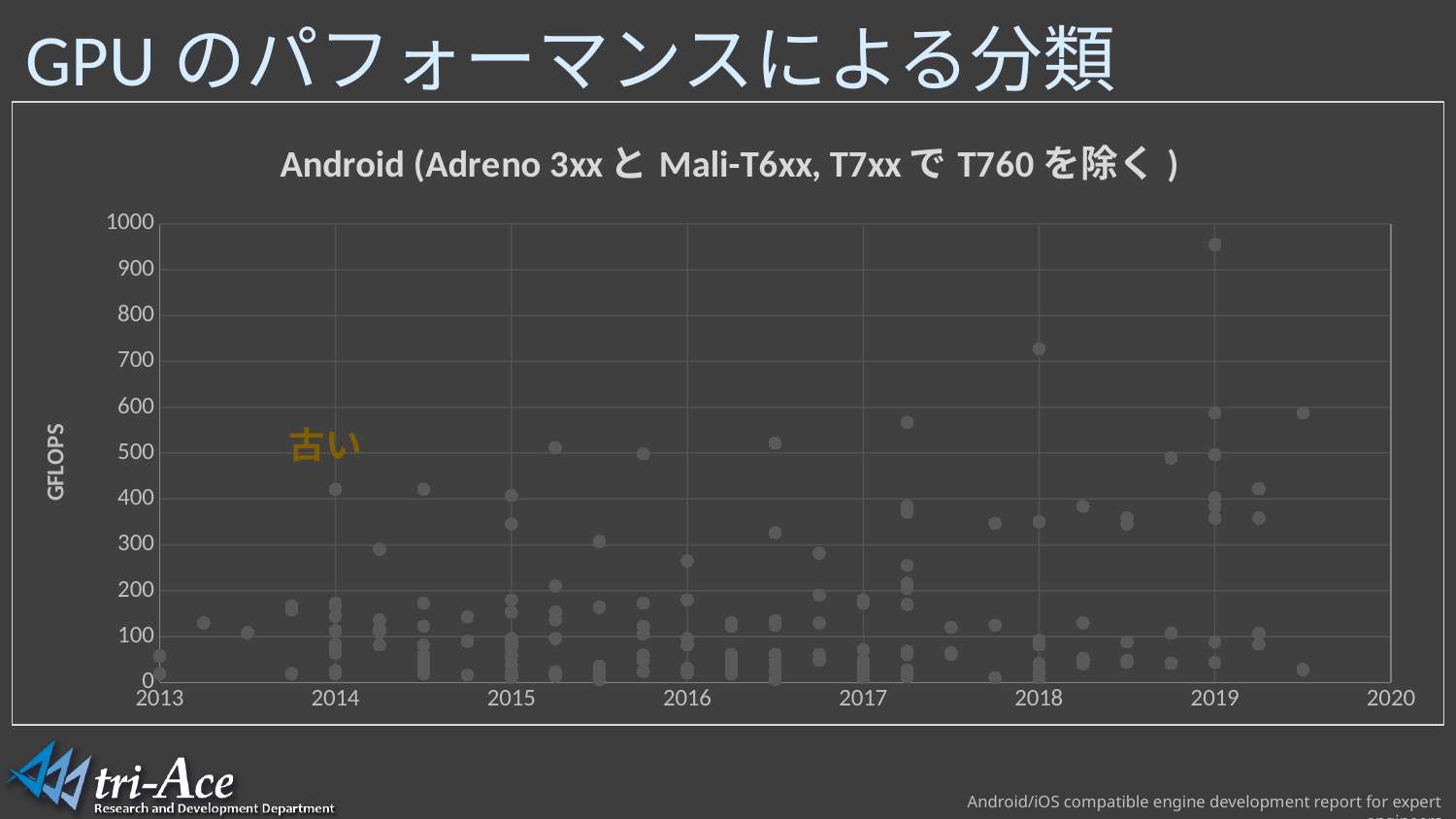
What kind of chart is shown on the slide? scatter chart What is the first year shown on the horizontal axis? 2013 Is the highest point on the chart greater or less than 900 GFLOPS? greater Near which year does the highest point on the chart appear? 2019 What is the title of the chart? Android (Adreno 3xx と Mali-T6xx, T7xx で T760 を除く ) How many year labels are shown on the horizontal axis? 8 What is the maximum value shown on the vertical axis? 1000 What is the interval between consecutive tick labels on the vertical axis? 100 What is the label on the vertical axis of the chart? GFLOPS Is the highest point near 2018 greater or less than 600 GFLOPS? greater What is the last year shown on the horizontal axis? 2020 Is the highest point near 2013 greater or less than 200 GFLOPS? less